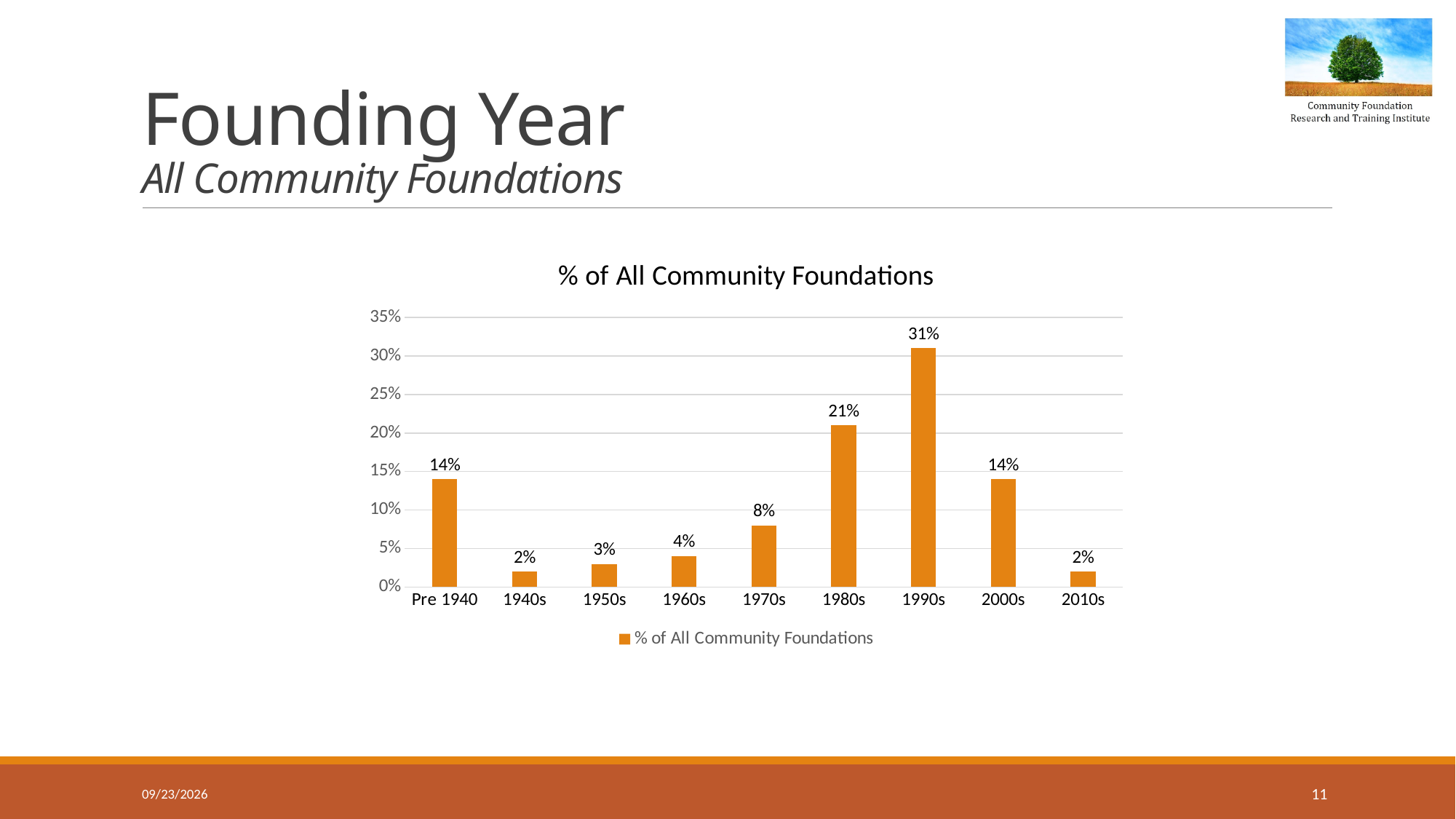
Which is larger, the value for the 2000s or the value for the 1960s? 2000s What is the title of the chart? % of All Community Foundations Is the value for the 1980s greater or less than 20%? greater Which category has the lowest value, the 1950s or the 1980s? 1950s What kind of chart is shown on the slide? Bar chart What percentage of all community foundations were founded in the 1990s? 31% How many founding-year categories are shown on the x axis? 9 What percentage of all community foundations were founded Pre 1940? 14% Which decade has the highest percentage of community foundations founded? 1990s How many series does the legend list? 1 What is the difference between the values for the 1990s and the 1980s? 10% What is the value shown for the 1970s? 8%